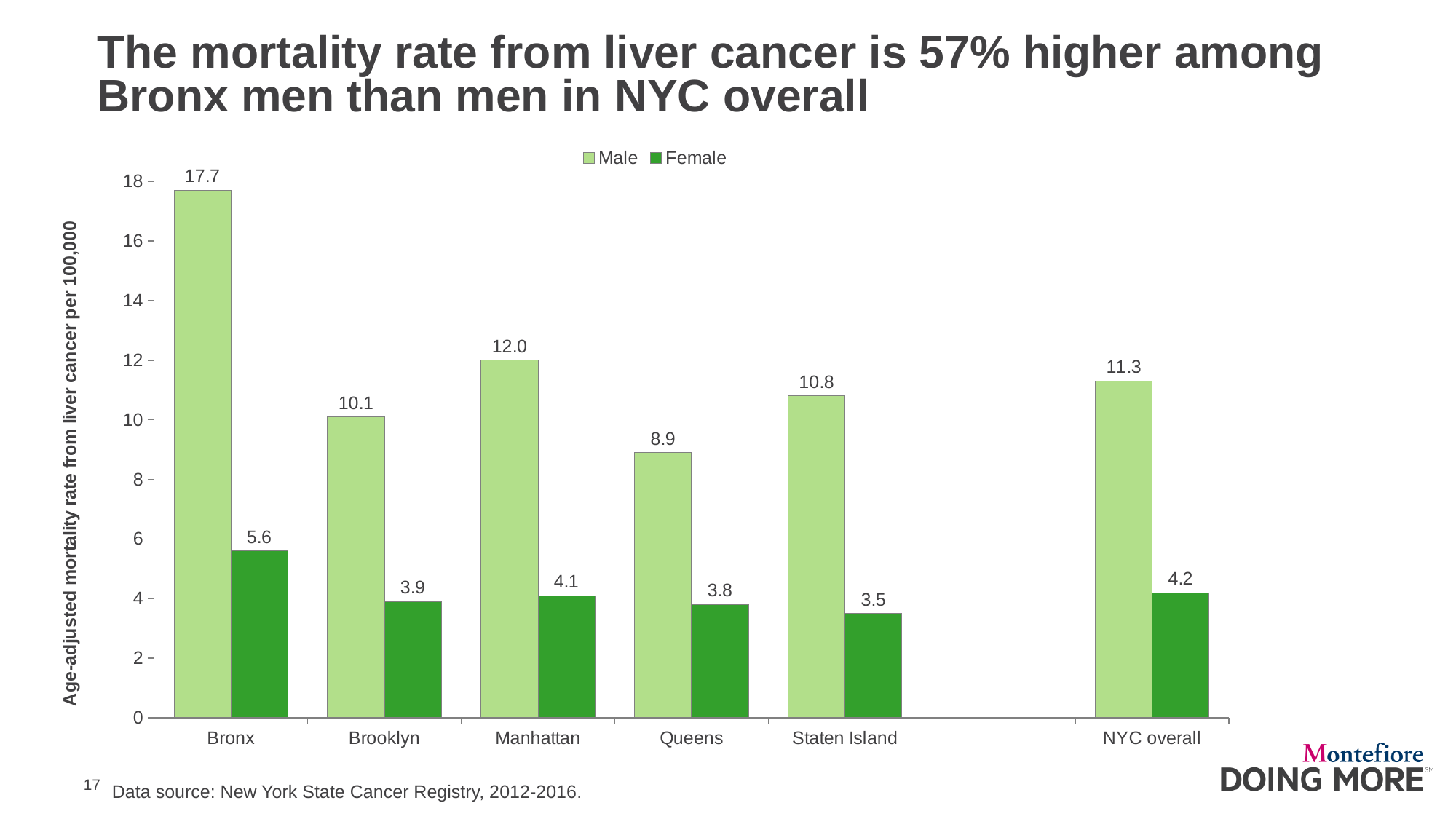
Which category has the lowest female mortality rate? Staten Island How many series does the legend list? 2 Which is larger, the male mortality rate for Manhattan or for Staten Island? Manhattan Which category has the lowest male mortality rate? Queens How many categories are shown on the x axis? 6 What is the female liver cancer mortality rate for Staten Island? 3.5 Is the male mortality rate for Queens greater or less than 10? less Which category has the highest male mortality rate? Bronx What is the male mortality rate for NYC overall? 11.3 What is the male liver cancer mortality rate for the Bronx? 17.7 What kind of chart is shown on the slide? Bar chart What is the difference between the male and female mortality rates in the Bronx? 12.1